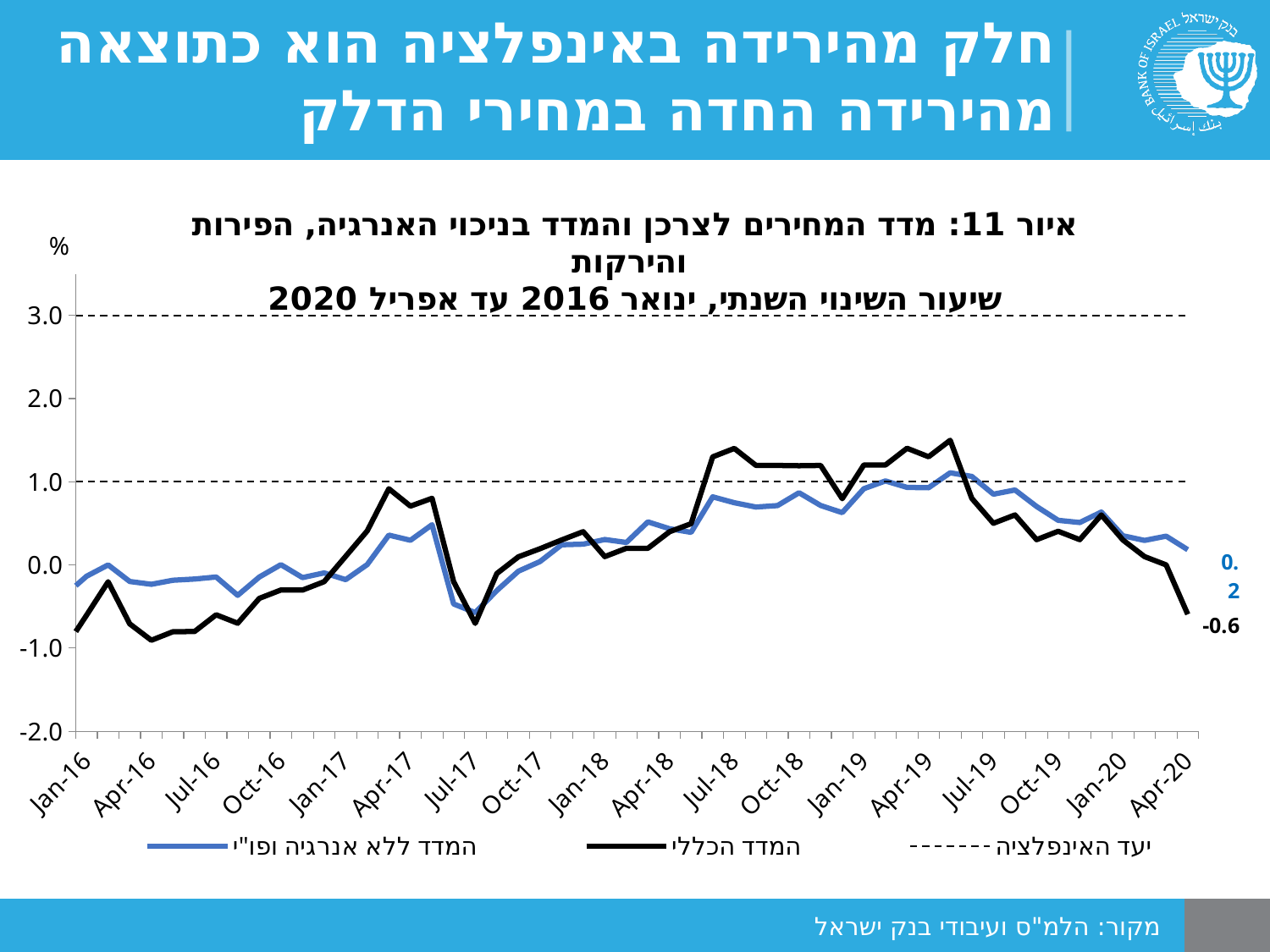
What is the value of המדד הכללי (the general index) at Apr-20, as labelled on the chart? -0.6 At what two levels are the dashed יעד האינפלציה (inflation target) lines drawn? 1.0 and 3.0 How many entries does the chart legend list? 3 How many date labels are shown on the x axis? 18 What kind of chart is shown on the slide? line chart Is the value of המדד ללא אנרגיה ופו"י at Jul-18 greater or less than 0.5? greater Is the value of המדד הכללי at Apr-16 greater or less than 0.0? less Is the value of המדד הכללי at Jul-18 greater or less than 1.0? greater What is the difference between the labelled Apr-20 values of המדד ללא אנרגיה ופו"י (0.2) and המדד הכללי (-0.6)? 0.8 At Apr-20, which series is higher: המדד הכללי or המדד ללא אנרגיה ופו"י? המדד ללא אנרגיה ופו"י Does המדד הכללי rise or fall between Jan-20 and Apr-20? fall What is the value of המדד ללא אנרגיה ופו"י at Apr-20, as labelled on the chart? 0.2